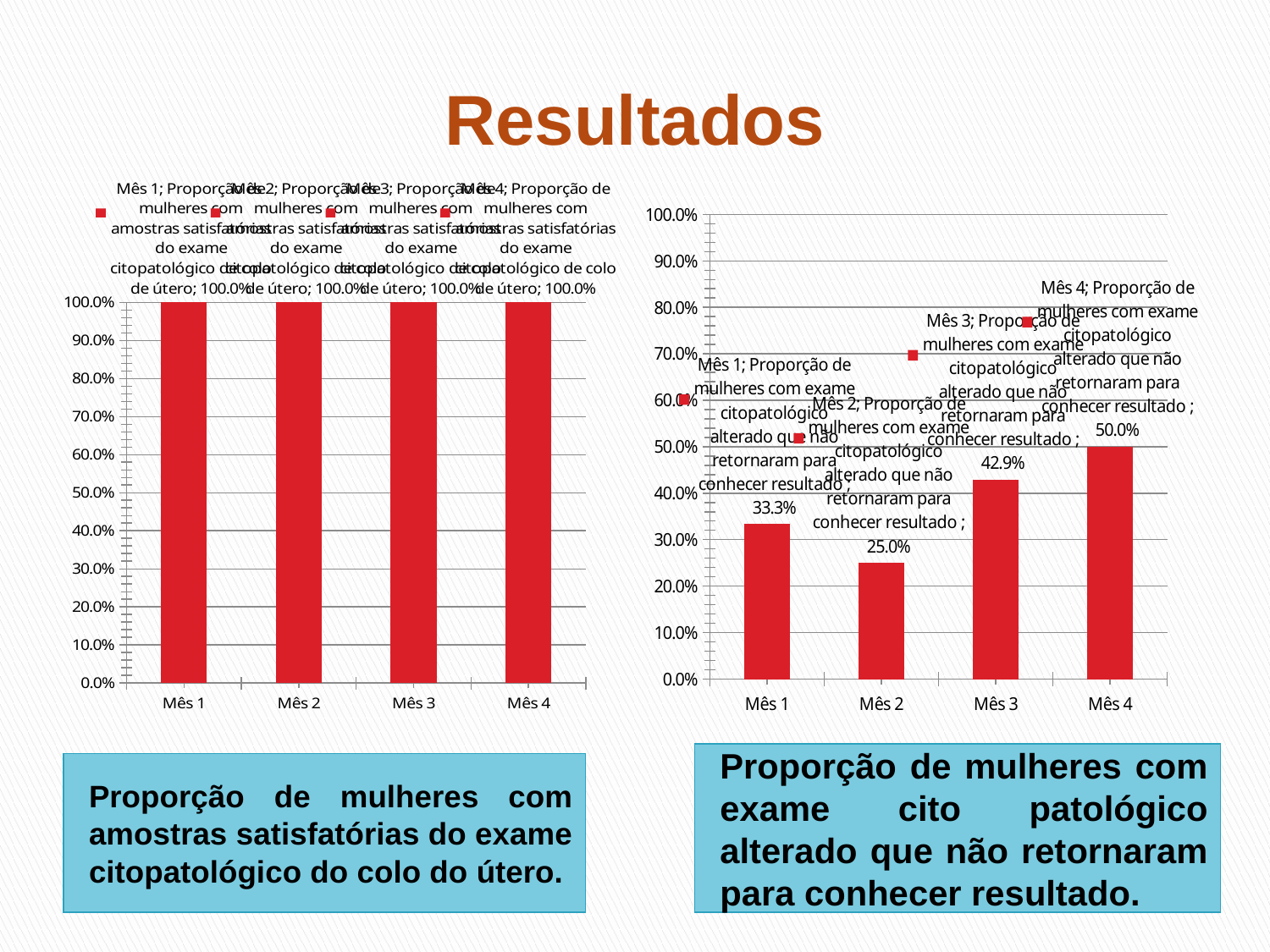
In the right chart, which month has the lowest value? Mês 2 In the right chart, what is the difference between the values for Mês 4 and Mês 2? 25.0% In the left chart, how many months are plotted on the x axis? 4 In the right chart, what is the value for Mês 3? 42.9% In the left chart, what is the value for Mês 4? 100.0% In the right chart, what is the value for Mês 2? 25.0% In the left chart, what is the value for Mês 1? 100.0% In the right chart, which is larger, the value for Mês 1 or the value for Mês 3? Mês 3 In the right chart, is the value for Mês 4 greater or less than 40.0%? greater What kind of chart is the left chart? bar chart In the right chart, what is the value for Mês 1? 33.3% In the right chart, which month has the highest value? Mês 4